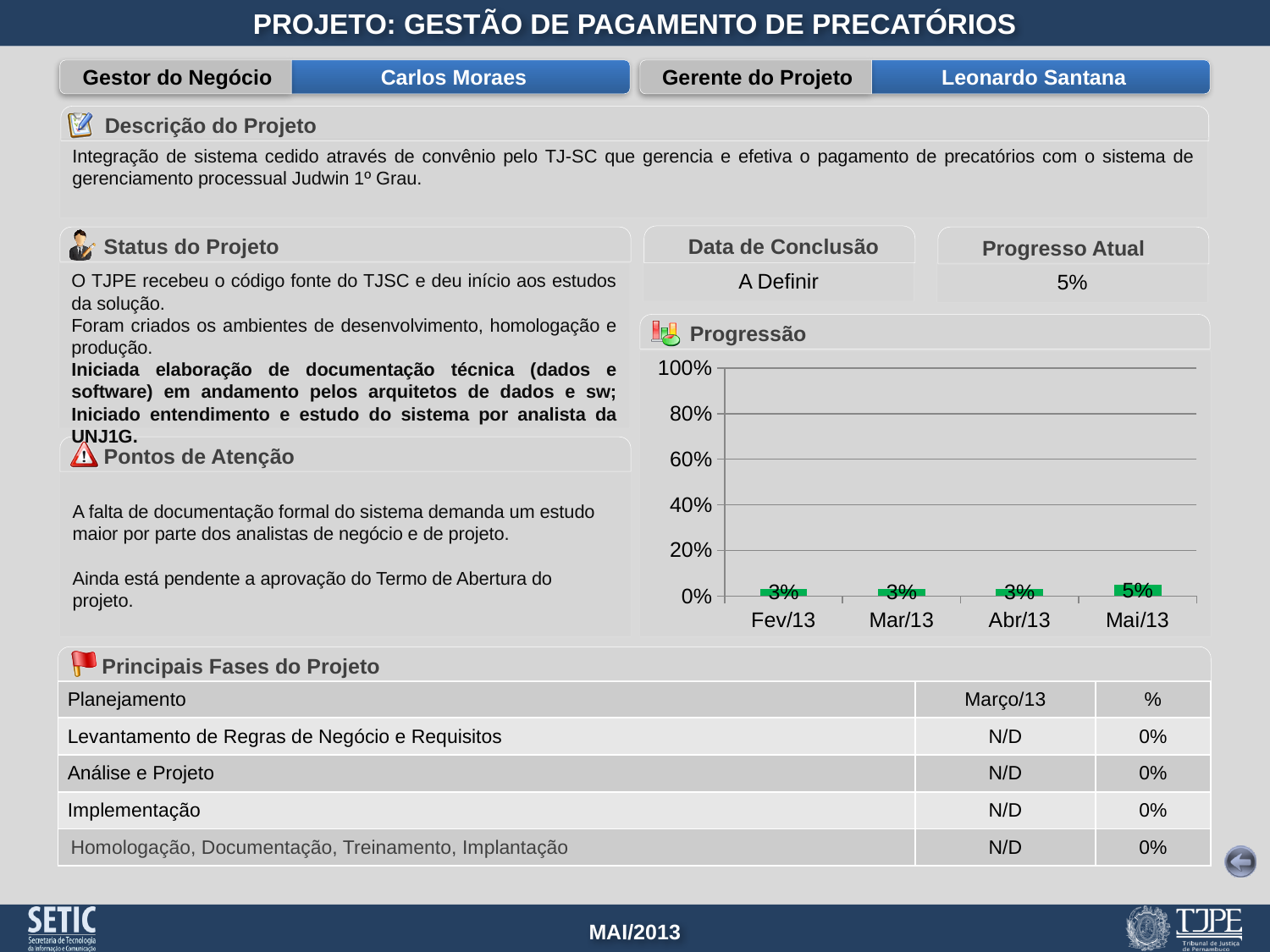
How many months are shown on the x axis of the Progressão chart? 4 In the Progressão chart, is the value for Mai/13 larger or smaller than the value for Mar/13? larger What is the difference between the values for Mai/13 and Abr/13 in the Progressão chart? 2% What is the value for Mai/13 in the Progressão chart? 5% What is the title of the chart on the slide? Progressão Which month has the highest value in the Progressão chart? Mai/13 Do the values in the Progressão chart rise or fall from Abr/13 to Mai/13? rise What kind of chart is the Progressão chart? bar chart What is the highest value shown on the y axis of the Progressão chart? 100% What is the value for Abr/13 in the Progressão chart? 3% Is the value for Mai/13 in the Progressão chart greater or less than 20%? less What is the value for Fev/13 in the Progressão chart? 3%